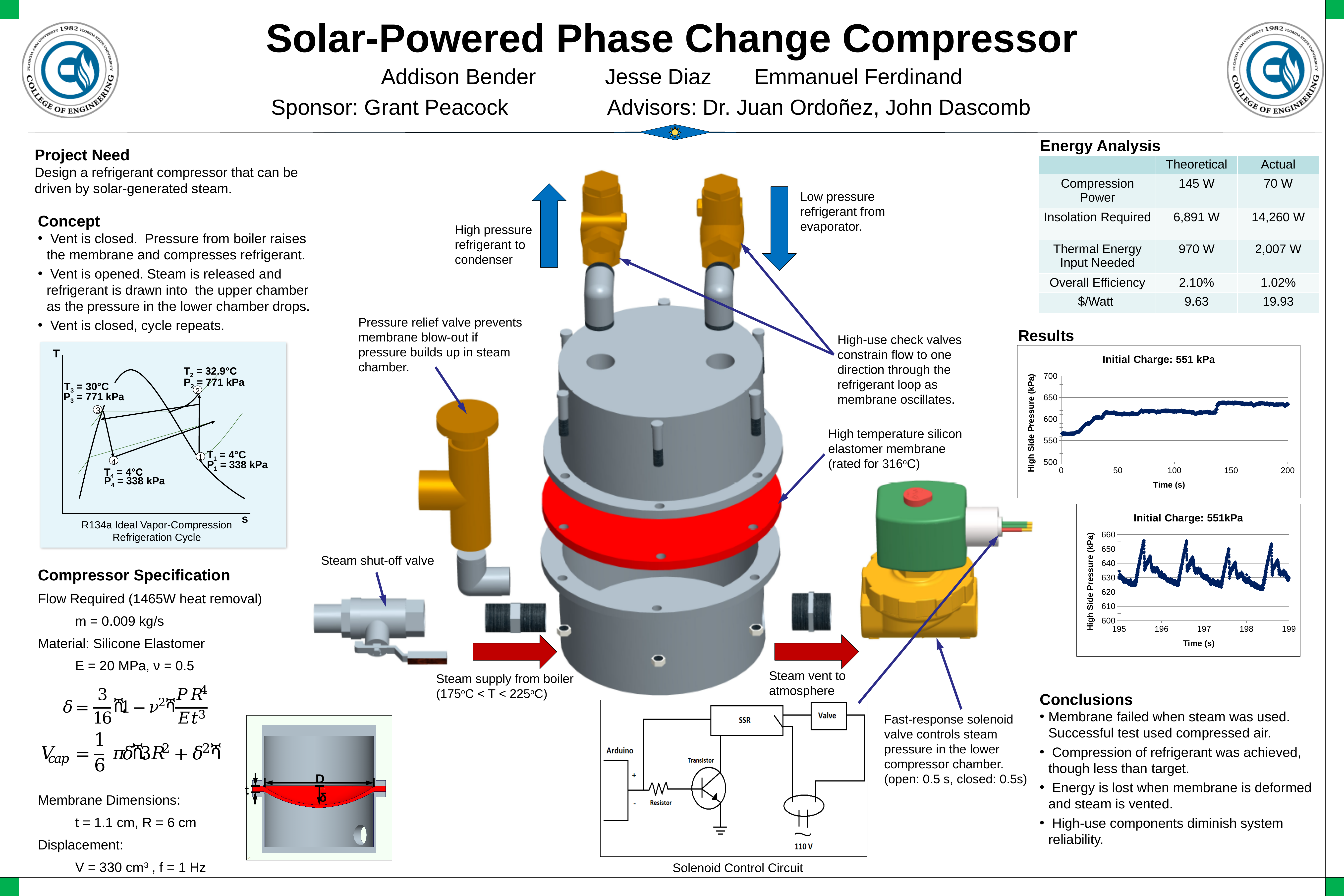
In the 'Initial Charge: 551 kPa' chart (0 to 200 s), do the pressure values generally rise or fall as time increases? rise In the 'Initial Charge: 551 kPa' chart (0 to 200 s), is the pressure at time 150 s greater or less than 600 kPa? greater What kind of chart is the 'Initial Charge: 551 kPa' chart with time from 0 to 200 s? scatter chart In the 'Initial Charge: 551 kPa' chart (0 to 200 s), is the pressure at time 200 s greater or less than 600 kPa? greater In the 'Initial Charge: 551kPa' chart (195 to 199 s), is the highest pressure value greater or less than 660 kPa? less What is the y-axis title of the 'Initial Charge: 551 kPa' chart (0 to 200 s)? High Side Pressure (kPa) What is the x-axis title of the 'Initial Charge: 551kPa' chart (195 to 199 s)? Time (s) How many charts are shown in the Results section of the slide? 2